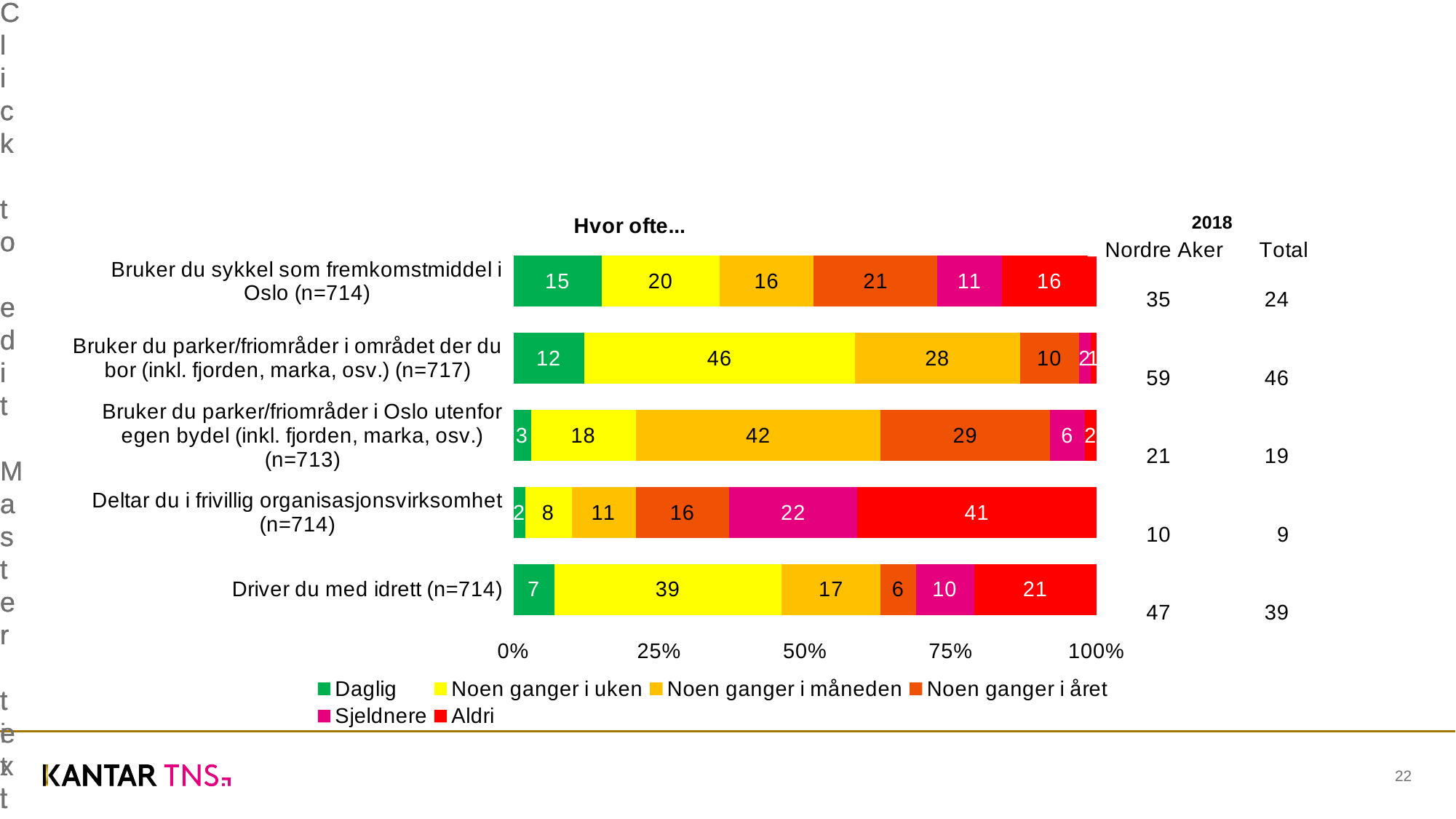
What type of chart is shown on the slide? Stacked bar chart Which is larger: the 'Noen ganger i uken' value for 'Bruker du parker/friområder i området der du bor' or for 'Driver du med idrett'? Bruker du parker/friområder i området der du bor What is the 'Noen ganger i måneden' value for 'Bruker du parker/friområder i Oslo utenfor egen bydel (inkl. fjorden, marka, osv.) (n=713)'? 42 How many categories (questions) are plotted in the chart? 5 What is the 'Daglig' value for 'Bruker du sykkel som fremkomstmiddel i Oslo (n=714)'? 15 What is the difference between the 'Aldri' values for 'Deltar du i frivillig organisasjonsvirksomhet (n=714)' and 'Driver du med idrett (n=714)'? 20 Which category has the highest 'Daglig' value? Bruker du sykkel som fremkomstmiddel i Oslo (n=714) What is the title of the chart? Hvor ofte... How many series does the legend list? 6 Which category has the lowest 'Aldri' value? Bruker du parker/friområder i området der du bor (inkl. fjorden, marka, osv.) (n=717) What is the 'Noen ganger i uken' value for 'Driver du med idrett (n=714)'? 39 What is the 'Aldri' value for 'Deltar du i frivillig organisasjonsvirksomhet (n=714)'? 41